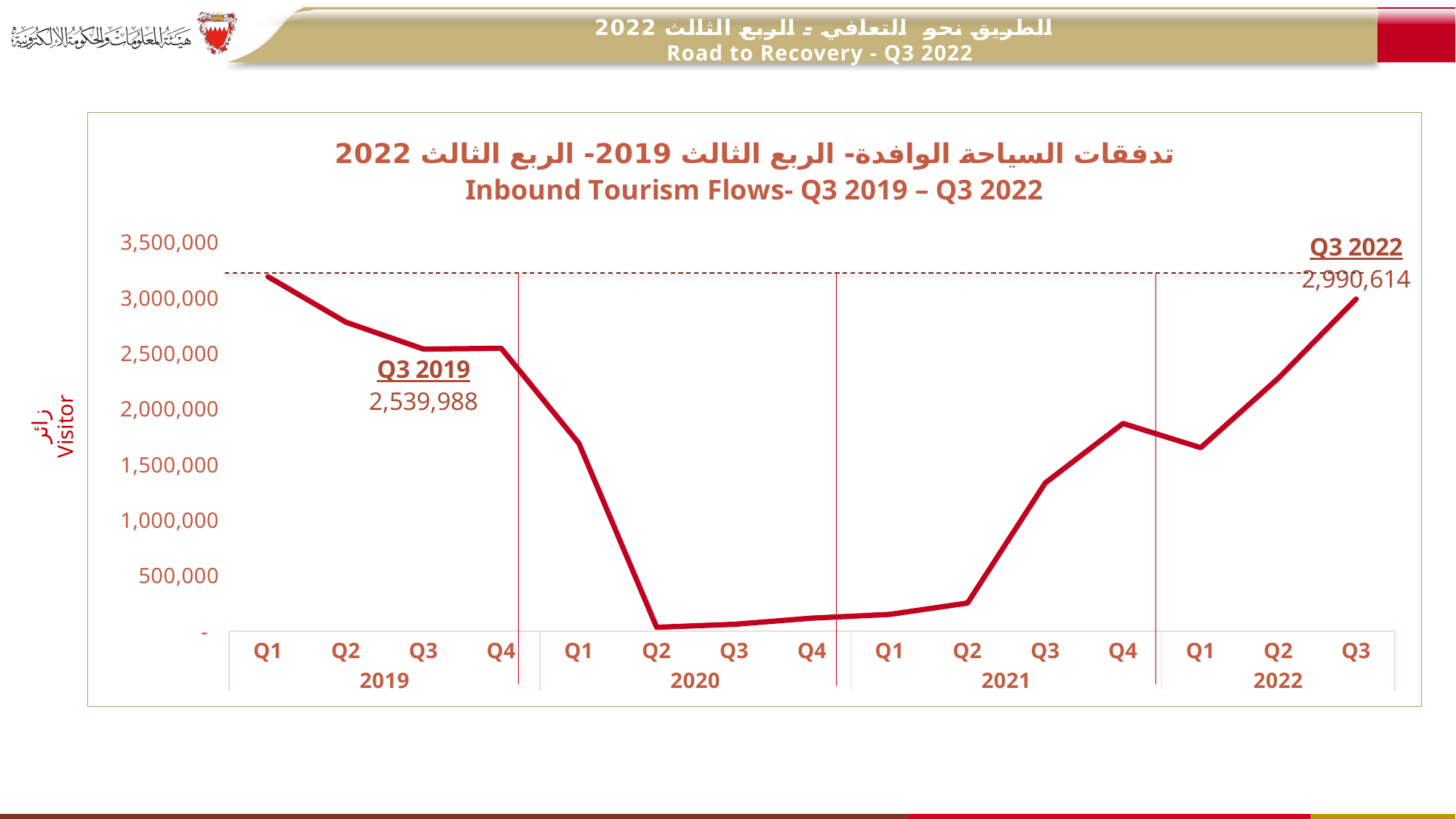
How many quarterly data points are plotted on the chart? 15 Which is larger, the value for Q3 2019 or the value for Q3 2022? Q3 2022 Is the value for Q2 2020 greater or less than 500,000? less Which quarter has the lowest number of visitors? Q2 2020 What is the number of visitors for Q3 2019? 2,539,988 Do the values rise or fall from Q1 2019 to Q2 2020? fall What is the number of visitors for Q3 2022? 2,990,614 What is the difference between the Q3 2022 value and the Q3 2019 value? 450,626 Which quarter has the highest number of visitors? Q1 2019 Is the value for Q1 2019 greater or less than 3,000,000? greater What type of chart is shown on the slide? Line chart Is the value for Q4 2021 greater or less than 2,000,000? less